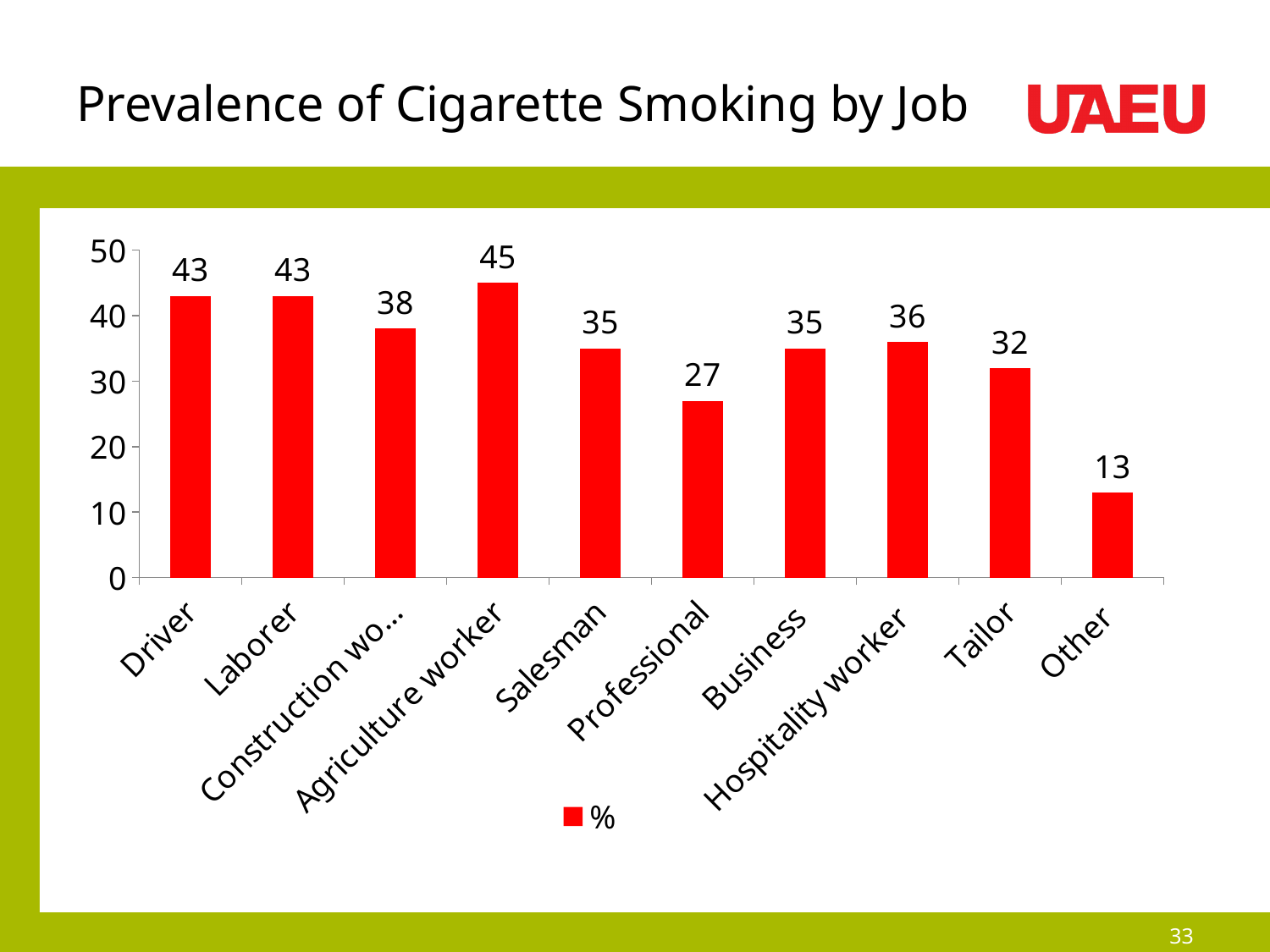
What is the value for Hospitality worker? 36 Which category has the lowest value? Other Which job has the highest value? Agriculture worker What kind of chart is shown on the slide? Bar chart Which is larger, the value for Salesman or the value for Professional? Salesman What is the difference between the values for Agriculture worker and Tailor? 13 What is the value for Driver? 43 What is the value for Professional? 27 How many job categories are shown in the chart? 10 What is the title of the chart on the slide? Prevalence of Cigarette Smoking by Job How many series does the legend list? 1 Is the value for Tailor greater or less than 30? greater